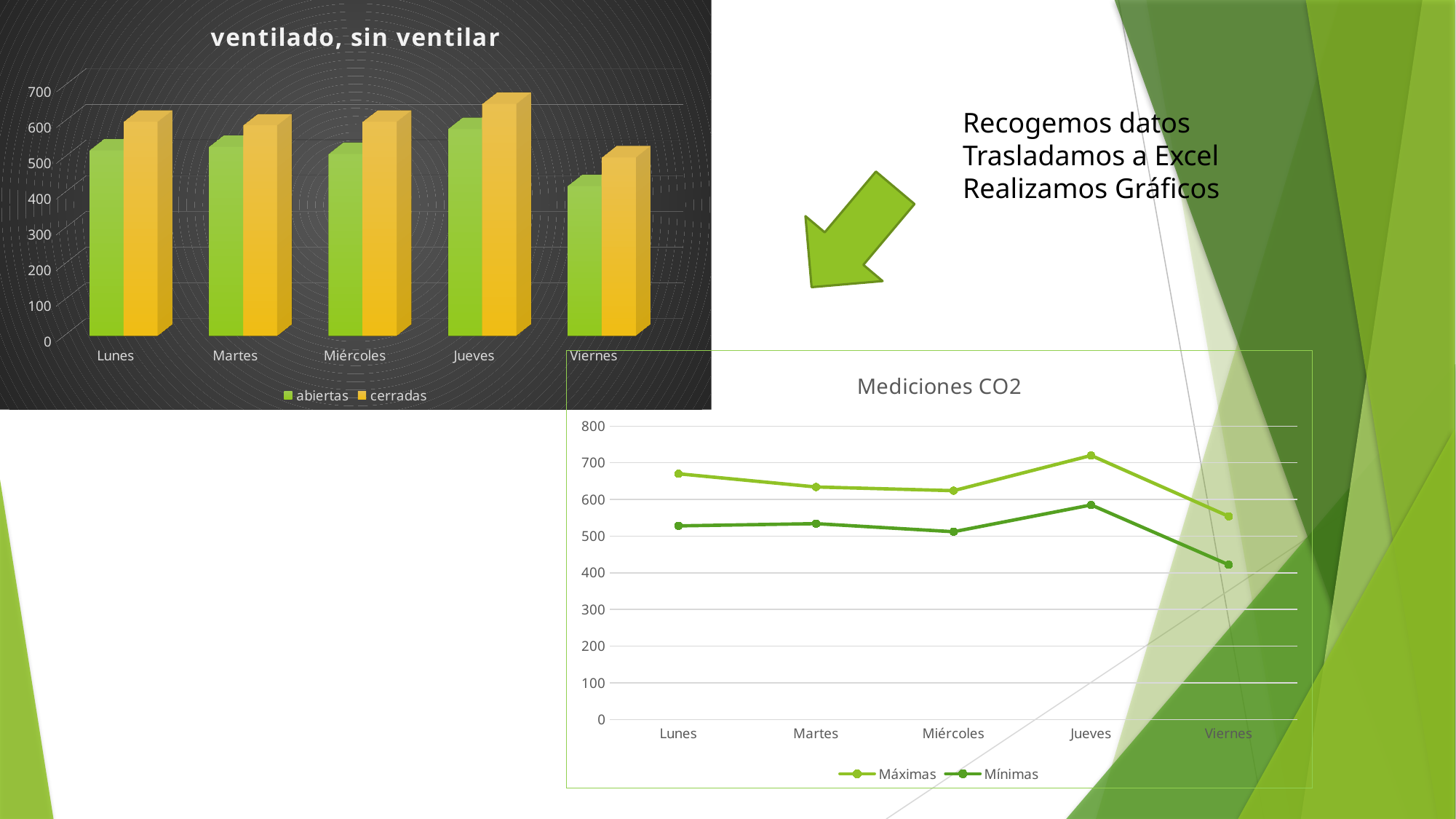
In the 'ventilado, sin ventilar' chart, which day has the lowest 'abiertas' bar? Viernes In the 'Mediciones CO2' chart, is the 'Máximas' value for Jueves greater or less than 700? greater In the 'Mediciones CO2' chart, does the 'Máximas' line rise or fall from Jueves to Viernes? fall In the 'ventilado, sin ventilar' chart, is the 'abiertas' value for Viernes greater or less than 500? less In the 'Mediciones CO2' chart, which day has the lowest 'Mínimas' value? Viernes In the 'ventilado, sin ventilar' chart, which is larger for Lunes, 'abiertas' or 'cerradas'? cerradas In the 'Mediciones CO2' chart, how many days are shown on the x axis? 5 In the 'Mediciones CO2' chart, what kind of chart is it? line chart In the 'ventilado, sin ventilar' chart, what kind of chart is it? bar chart In the 'ventilado, sin ventilar' chart, how many series does the legend list? 2 In the 'ventilado, sin ventilar' chart, which day has the highest 'cerradas' bar? Jueves In the 'Mediciones CO2' chart, which day has the highest 'Máximas' value? Jueves